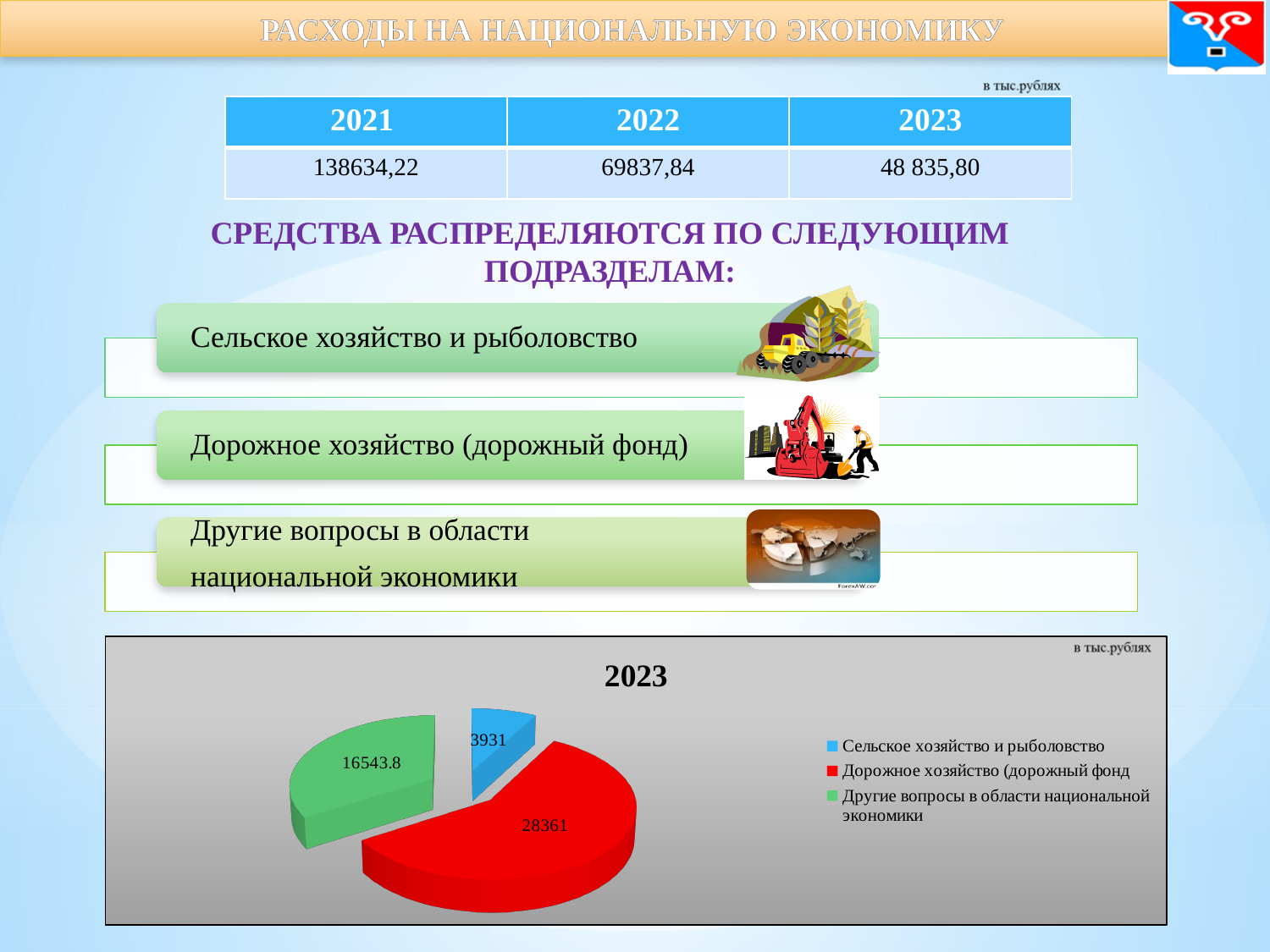
What is the title of the pie chart? 2023 How many entries does the pie chart's legend list? 3 What is the value for Другие вопросы в области национальной экономики in the pie chart? 16543.8 In the pie chart, what is the difference between the value for Дорожное хозяйство (дорожный фонд) and the value for Сельское хозяйство и рыболовство? 24430 What colour is the slice for Дорожное хозяйство (дорожный фонд) in the pie chart? Red Which category has the smallest slice in the pie chart? Сельское хозяйство и рыболовство How many slices does the pie chart have? 3 In the pie chart, which is larger: Другие вопросы в области национальной экономики or Сельское хозяйство и рыболовство? Другие вопросы в области национальной экономики Which category has the largest slice in the pie chart? Дорожное хозяйство (дорожный фонд) What kind of chart is shown at the bottom of the slide? Pie chart What is the value for Сельское хозяйство и рыболовство in the pie chart? 3931 What is the value for Дорожное хозяйство (дорожный фонд) in the pie chart? 28361